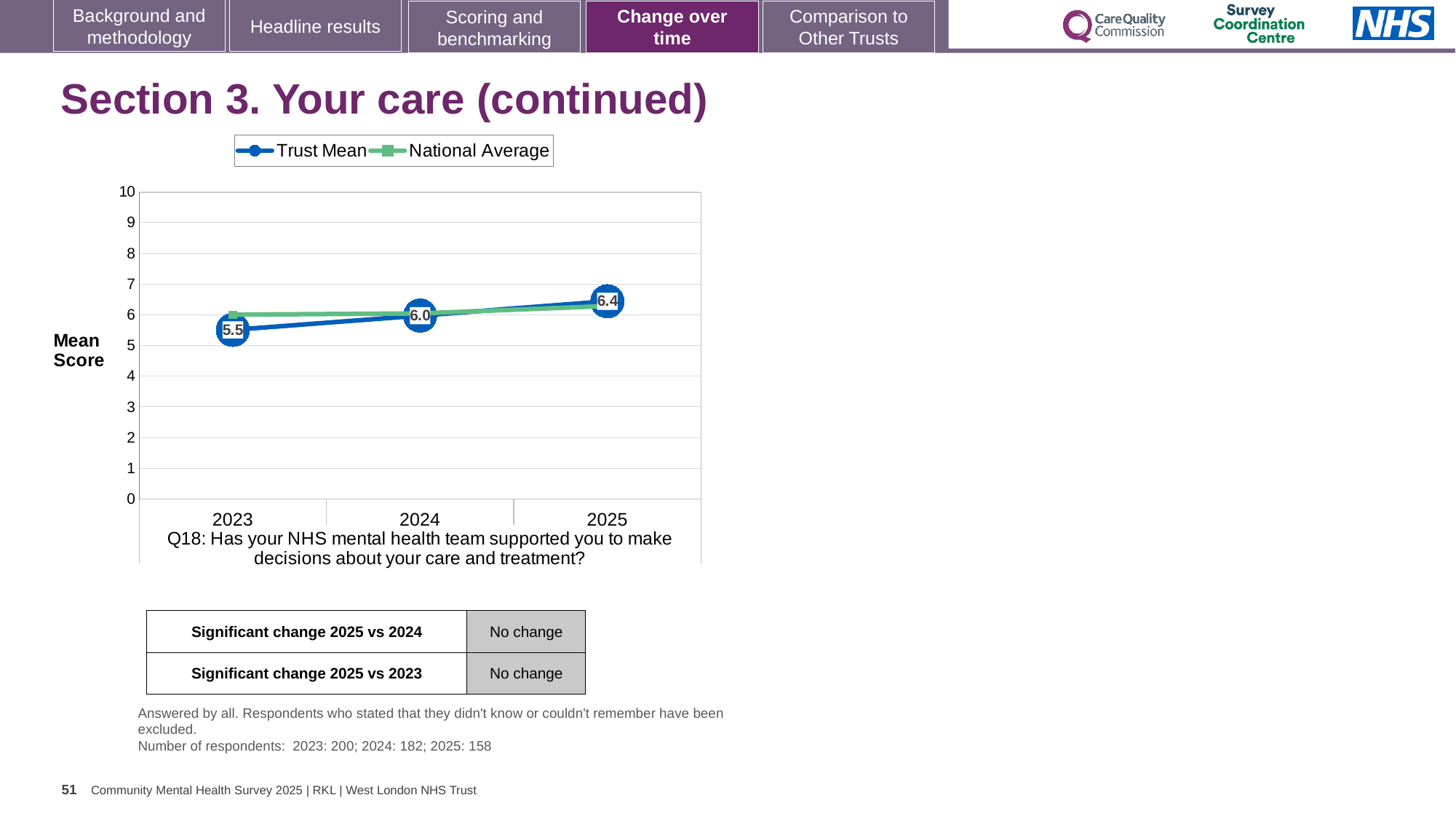
In which year is the Trust Mean score lowest? 2023 Is the National Average value for 2025 greater or less than 7? less In 2023, which is larger: the Trust Mean or the National Average? National Average What type of chart is shown on the slide? line chart How many series does the legend list? 2 What is the Trust Mean score for 2023? 5.5 What is the difference between the Trust Mean score in 2025 and in 2023? 0.9 In which year is the Trust Mean score highest? 2025 What is the Trust Mean score for 2025? 6.4 What is the difference between the Trust Mean score in 2024 and in 2023? 0.5 What is the Trust Mean score for 2024? 6.0 Does the Trust Mean rise or fall from 2023 to 2025? rise